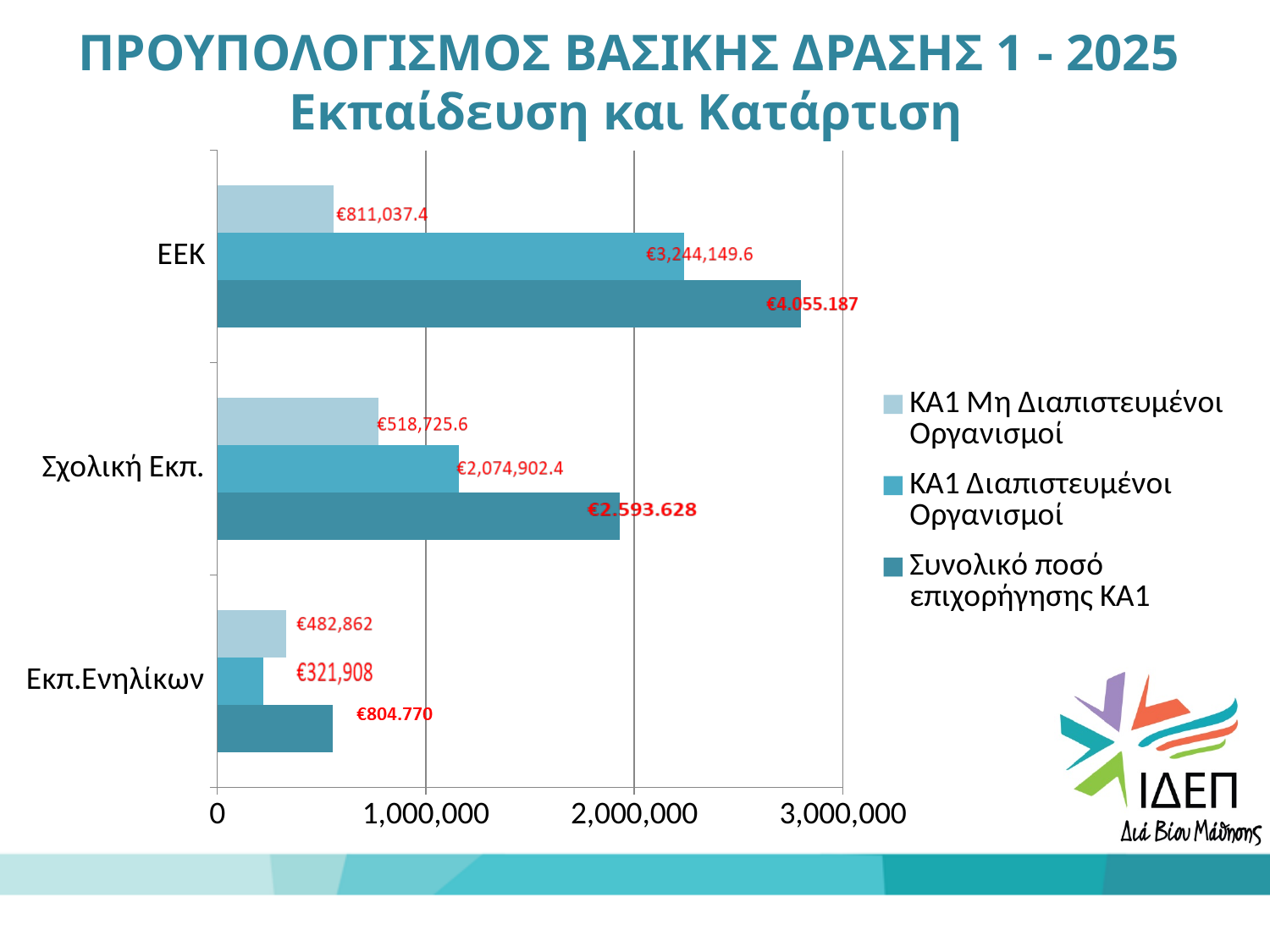
What is the value for ΚΑ1 Διαπιστευμένοι Οργανισμοί in the Εκπ.Ενηλίκων category? €321,908 What is the Συνολικό ποσό επιχορήγησης ΚΑ1 for Σχολική Εκπ.? €2.593.628 What is the value for ΚΑ1 Μη Διαπιστευμένοι Οργανισμοί in the ΕΕΚ category? €811,037.4 How many series does the legend list? 3 Which category has the highest Συνολικό ποσό επιχορήγησης ΚΑ1? ΕΕΚ Which category has the lowest value for ΚΑ1 Διαπιστευμένοι Οργανισμοί? Εκπ.Ενηλίκων How many categories are shown on the vertical axis of the chart? 3 What type of chart is shown on the slide? Bar chart What is the value for ΚΑ1 Μη Διαπιστευμένοι Οργανισμοί in the Σχολική Εκπ. category? €518,725.6 What is the title of the chart on the slide? ΠΡΟΥΠΟΛΟΓΙΣΜΟΣ ΒΑΣΙΚΗΣ ΔΡΑΣΗΣ 1 - 2025 Εκπαίδευση και Κατάρτιση What is the value for ΚΑ1 Διαπιστευμένοι Οργανισμοί in the ΕΕΚ category? €3,244,149.6 In the Εκπ.Ενηλίκων category, which is larger: ΚΑ1 Μη Διαπιστευμένοι Οργανισμοί or ΚΑ1 Διαπιστευμένοι Οργανισμοί? ΚΑ1 Μη Διαπιστευμένοι Οργανισμοί